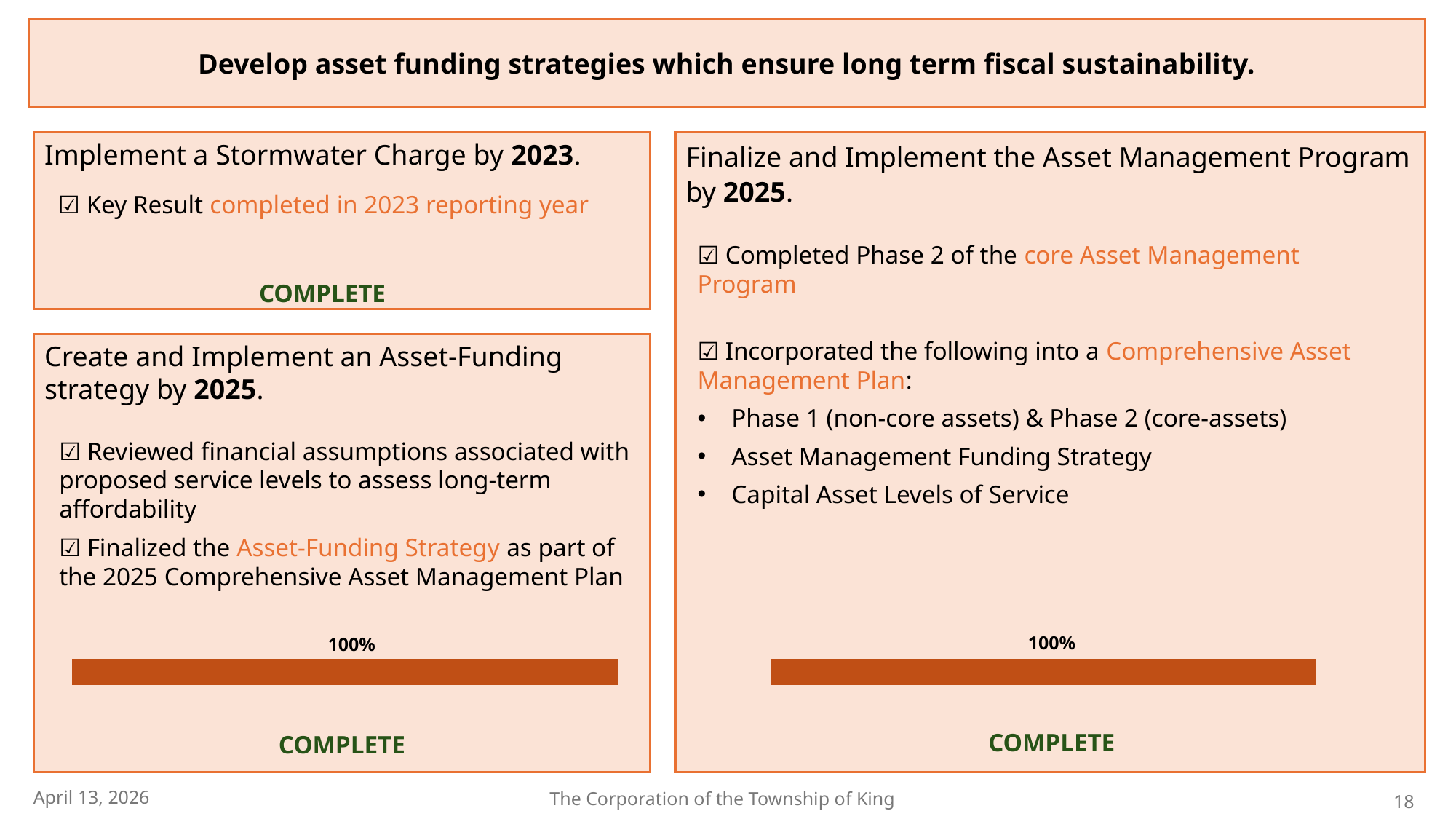
How many bars are plotted in the progress chart in the 'Finalize and Implement the Asset Management Program by 2025' box? 1 What kind of chart is used to show progress in the 'Create and Implement an Asset-Funding strategy by 2025' box? bar chart Is the value shown on the progress bar in the 'Create and Implement an Asset-Funding strategy by 2025' box greater or less than 50%? greater On the progress bar in the 'Create and Implement an Asset-Funding strategy by 2025' box, what value is shown? 100% On the progress bar in the 'Finalize and Implement the Asset Management Program by 2025' box, what value is shown? 100% What colour is the progress bar in the 'Finalize and Implement the Asset Management Program by 2025' box? orange What status word is printed below the progress bar in the 'Create and Implement an Asset-Funding strategy by 2025' box? COMPLETE How many progress bar charts appear on the slide? 2